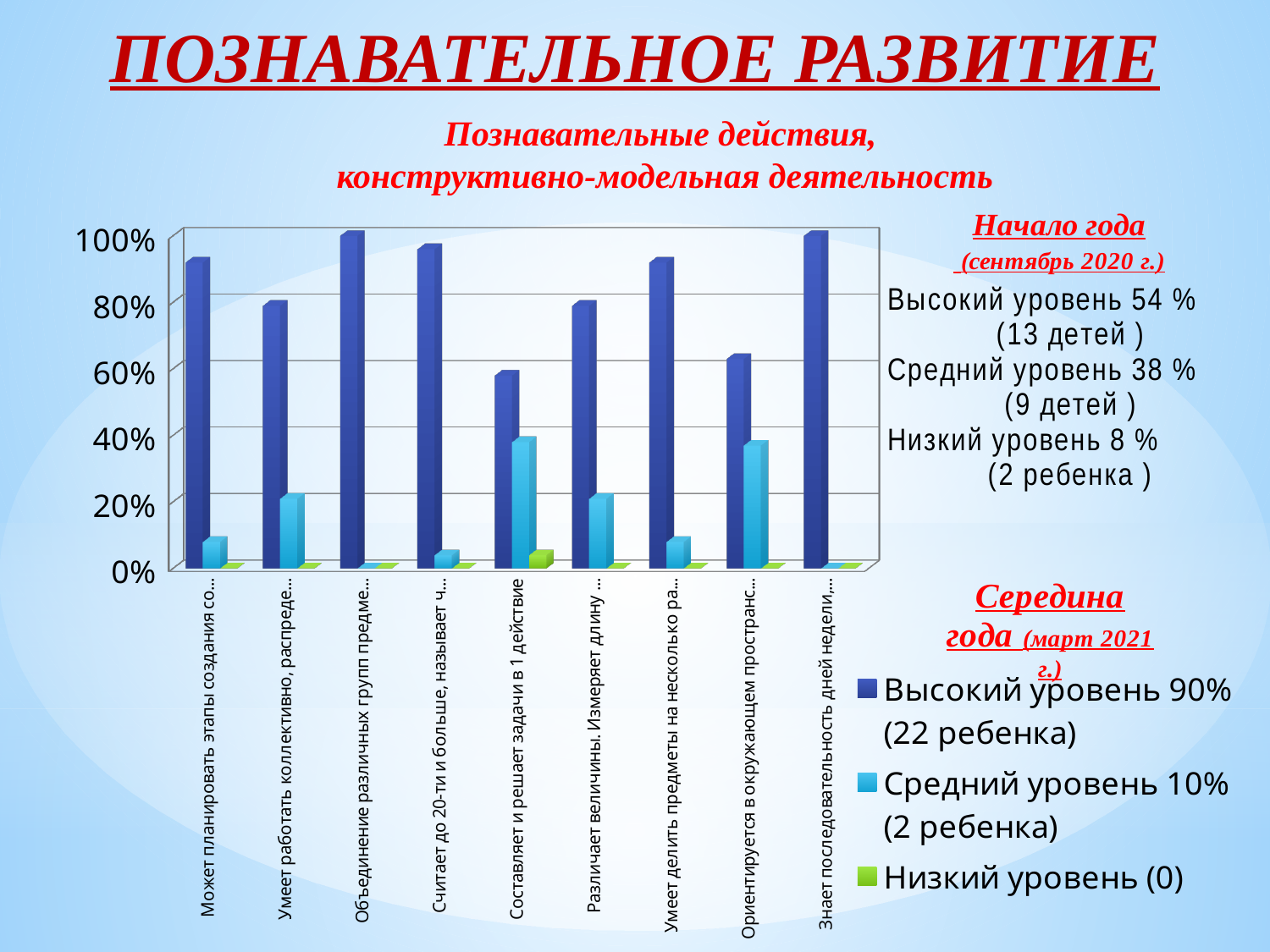
How many series does the chart legend list? 3 What is the Высокий уровень value for "Знает последовательность дней недели,..."? 100% Which is larger: the Высокий уровень value for "Умеет работать коллективно, распреде..." or for "Считает до 20-ти и больше, называет ч..."? Считает до 20-ти и больше, называет ч... Which series has the highest value in every category of the chart? Высокий уровень Which is larger: the Средний уровень value for "Может планировать этапы создания со..." or for "Умеет работать коллективно, распреде..."? Умеет работать коллективно, распреде... Is the value of Высокий уровень for "Составляет и решает задачи в 1 действие" greater or less than 80%? less Is the value of Высокий уровень for "Ориентируется в окружающем пространс..." greater or less than 80%? less Is the value of Средний уровень for "Составляет и решает задачи в 1 действие" greater or less than 20%? greater What colour represents Низкий уровень in the chart legend? green What kind of chart is shown on the slide? bar chart How many categories are plotted along the x axis of the chart? 9